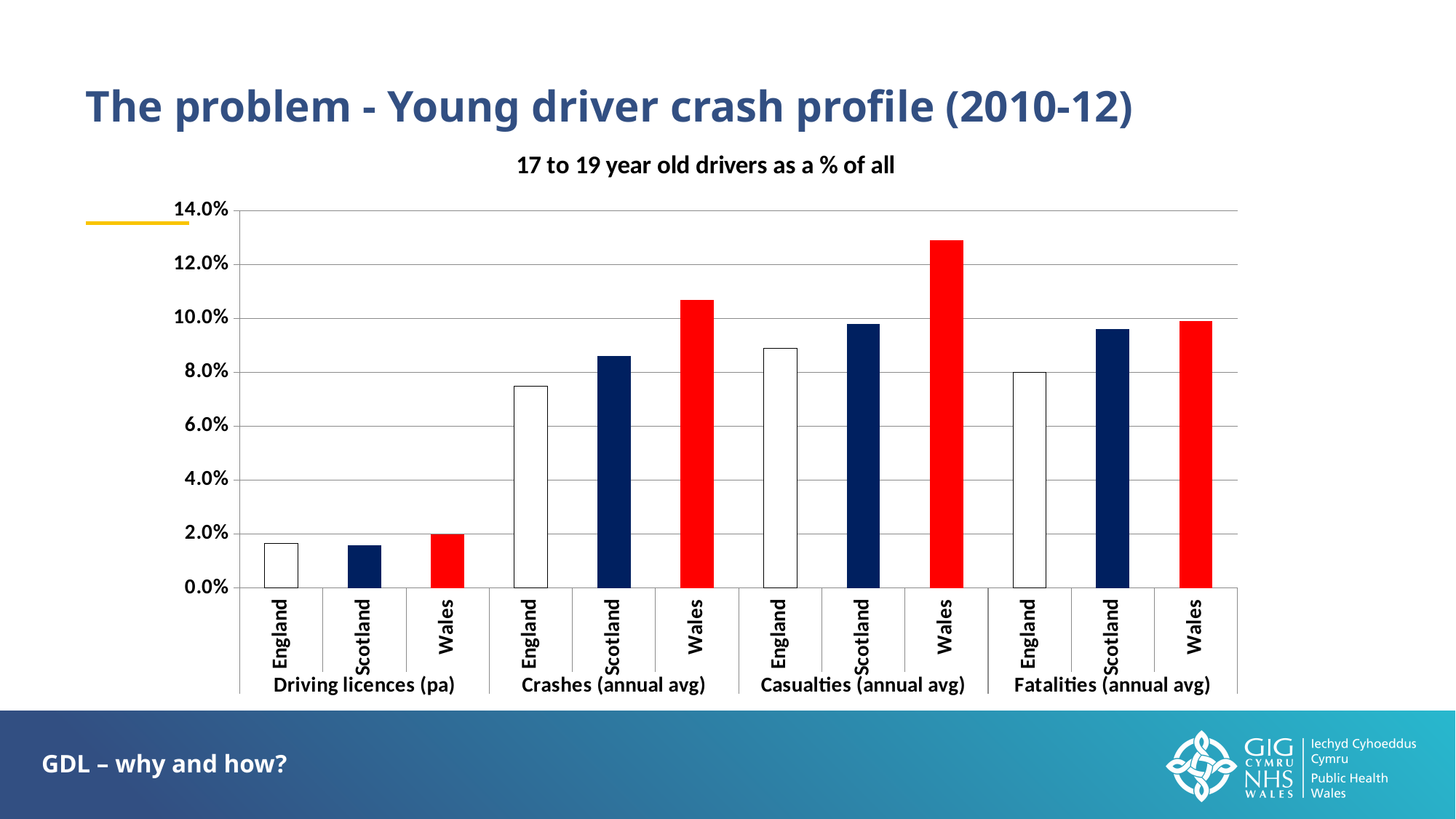
What kind of chart is shown on the slide? bar chart Which category group has the lowest values overall? Driving licences (pa) How many category groups are shown along the x axis of the chart? 4 What is the title of the chart? 17 to 19 year old drivers as a % of all Within the Casualties (annual avg) group, which country has the highest value? Wales In the Crashes (annual avg) group, which is larger, the value for Wales or the value for England? Wales Which bar is the highest in the whole chart? Wales, Casualties (annual avg) Is the value for Scotland in the Fatalities (annual avg) group greater or less than 10.0%? less Within the Crashes (annual avg) group, which country has the lowest value? England How many bars are plotted in the chart in total? 12 Is the value for England in the Crashes (annual avg) group greater or less than 8.0%? less Is the value for Wales in the Casualties (annual avg) group greater or less than 12.0%? greater